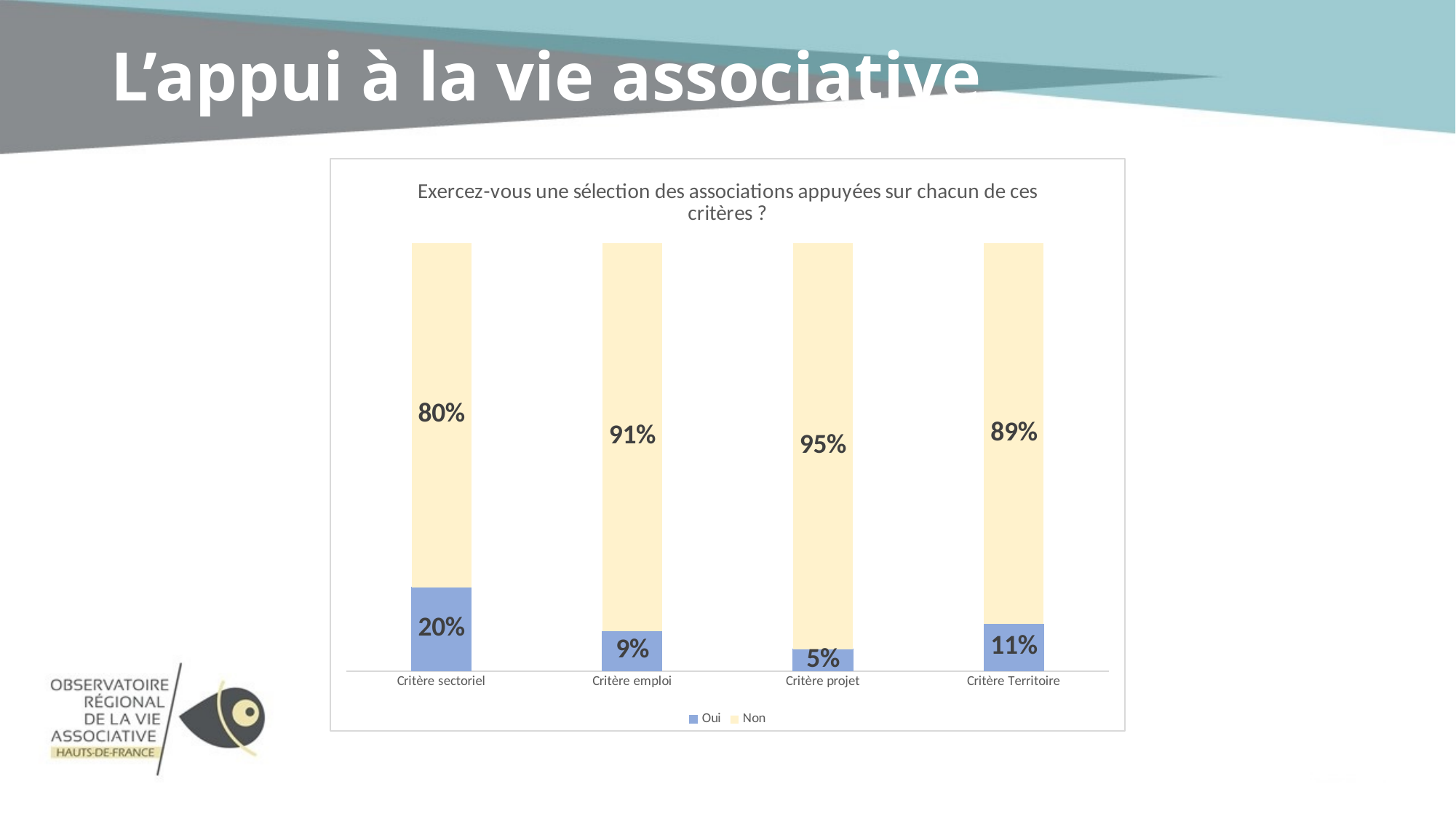
What is the 'Oui' value for Critère sectoriel? 20% Which category has the lowest 'Oui' value? Critère projet What is the 'Non' value for Critère emploi? 91% What kind of chart is this? Stacked bar chart How many series does the legend list? 2 Which category has the highest 'Oui' value? Critère sectoriel What is the total of the stacked bar for Critère Territoire? 100% How many categories are shown on the x axis? 4 What is the 'Non' value for Critère projet? 95% Which is larger: the 'Non' value for Critère Territoire or the 'Non' value for Critère emploi? Critère emploi What is the 'Oui' value for Critère Territoire? 11% What is the difference between the 'Oui' values for Critère sectoriel and Critère emploi? 11%